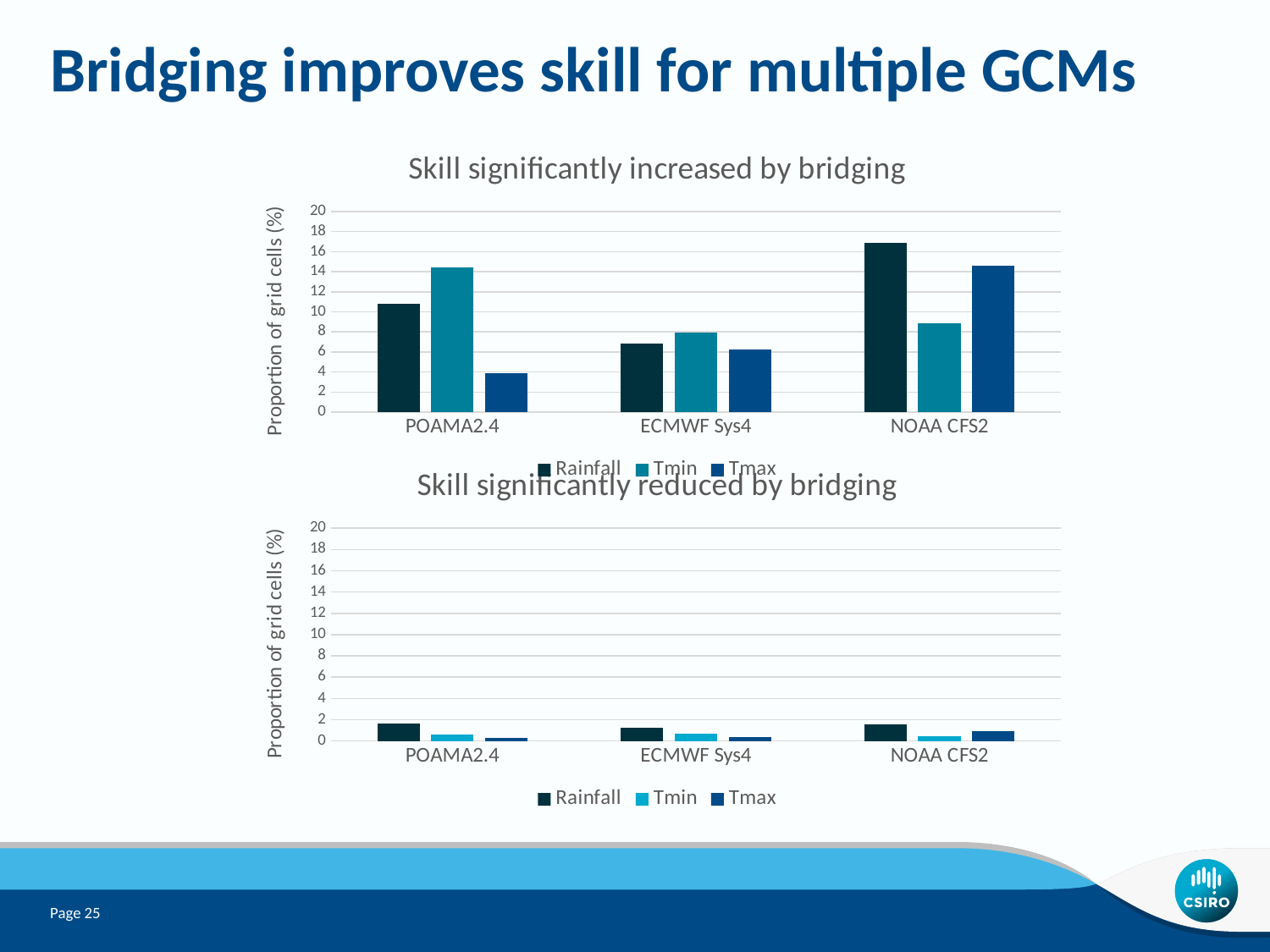
In the 'Skill significantly reduced by bridging' chart, which series has the highest value for ECMWF Sys4? Rainfall In the 'Skill significantly reduced by bridging' chart, is the Rainfall value for POAMA2.4 greater or less than 4? less In the 'Skill significantly increased by bridging' chart, is the Rainfall value for NOAA CFS2 greater or less than 14? greater In the 'Skill significantly increased by bridging' chart, which GCM has the highest Rainfall value? NOAA CFS2 In the 'Skill significantly increased by bridging' chart, which is larger for POAMA2.4: Rainfall or Tmin? Tmin What is the y-axis title of the 'Skill significantly reduced by bridging' chart? Proportion of grid cells (%) What kind of chart is the 'Skill significantly increased by bridging' chart? bar chart In the 'Skill significantly increased by bridging' chart, which is larger for NOAA CFS2: Rainfall or Tmin? Rainfall How many series does the legend of the 'Skill significantly increased by bridging' chart list? 3 In the 'Skill significantly increased by bridging' chart, which GCM has the lowest Tmax value? POAMA2.4 How many GCM categories are shown on the x axis of the 'Skill significantly reduced by bridging' chart? 3 In the 'Skill significantly increased by bridging' chart, is the Tmax value for POAMA2.4 greater or less than 6? less